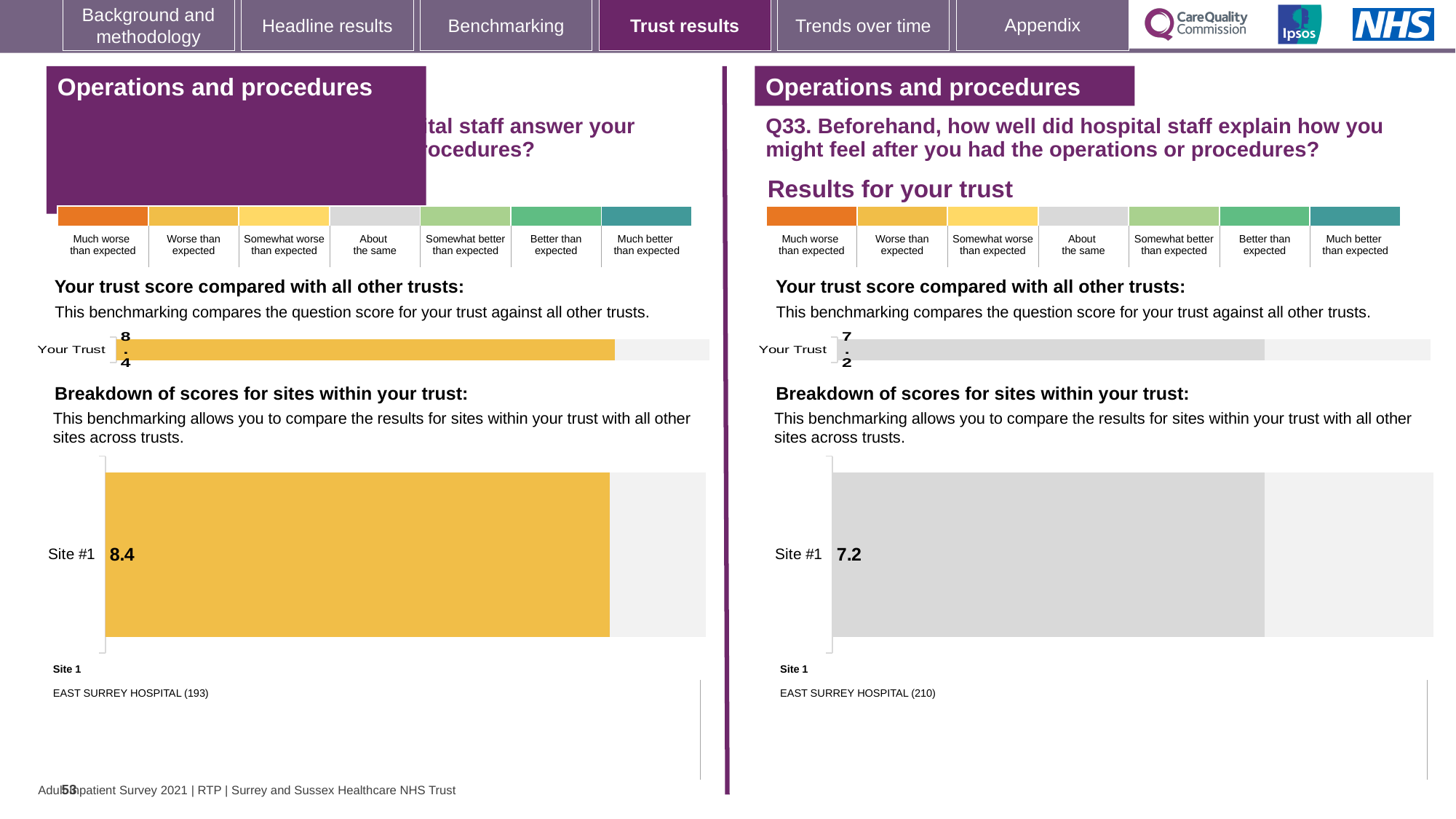
What kind of chart is used for the site breakdown on the left panel? Bar chart Which is larger: the Site #1 score on the left panel or the Site #1 score on the right panel (Q33)? Left panel (8.4) What colour is the Site #1 bar on the right panel (Q33), and which benchmark category does that colour correspond to? Grey; About the same Is the Site #1 score on the left panel greater or less than 8? greater Is the 'Your Trust' score on the right panel (Q33) greater or less than 8? less On the left panel, what is the 'Your Trust' score shown in the trust benchmarking bar? 8.4 On the left panel's site breakdown chart, what is the score for Site #1? 8.4 On the right panel's (Q33) site breakdown chart, what is the score for Site #1? 7.2 On the right panel (Q33), what is the 'Your Trust' score shown in the trust benchmarking bar? 7.2 How many sites are shown in the site breakdown chart on the right panel (Q33)? 1 What is the difference between the Site #1 score on the left panel and the Site #1 score on the right panel (Q33)? 1.2 Which hospital is listed as Site 1 on the right panel (Q33)? EAST SURREY HOSPITAL (210)